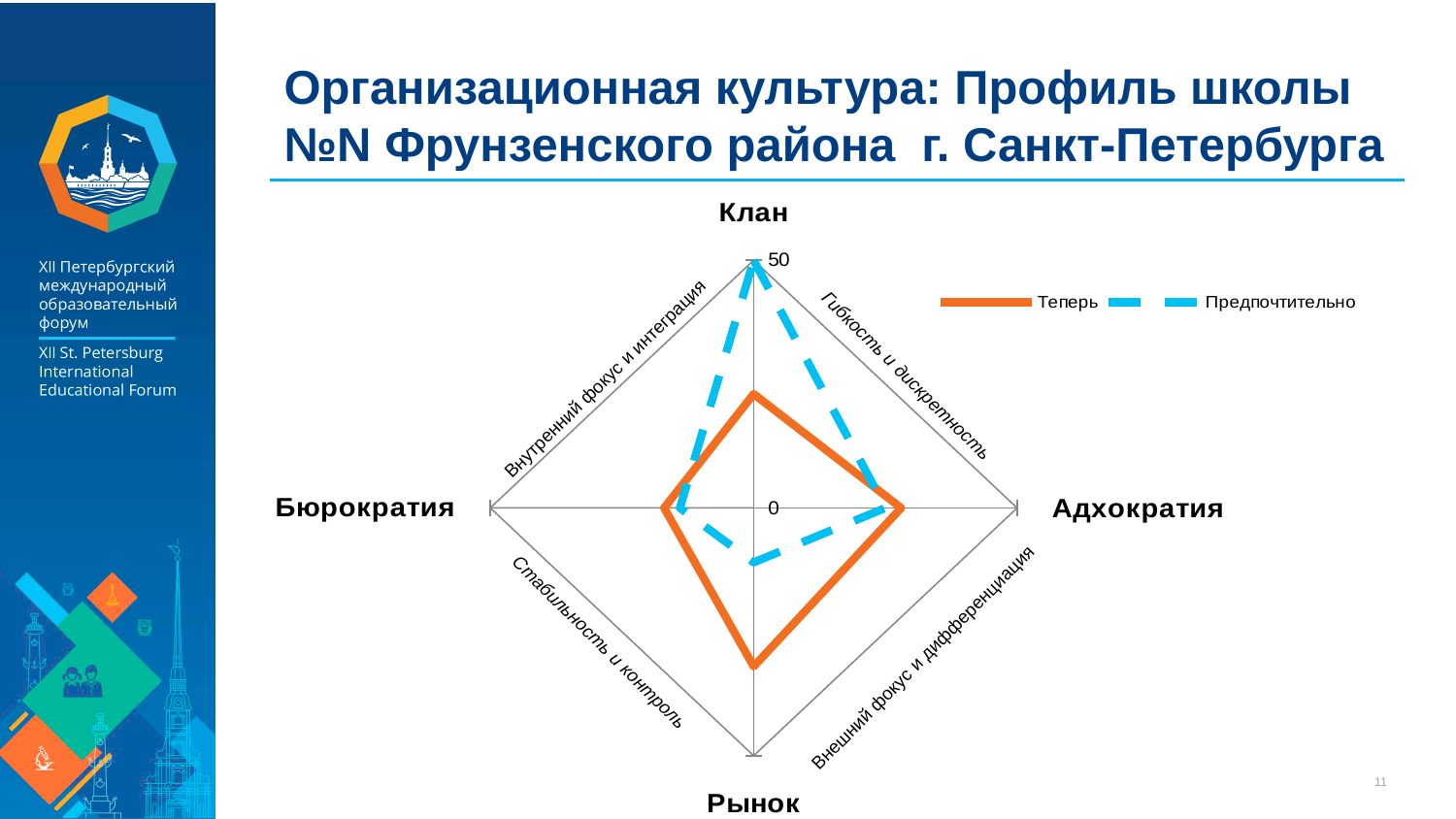
How many categories (axes) does the radar chart have? 4 Is the Предпочтительно value for Рынок greater or less than 50? less Which category is at the top of the radar chart? Клан What kind of chart is shown on the slide? Radar chart In which category does the Предпочтительно series have its highest value? Клан For Рынок, which series has the larger value, Теперь or Предпочтительно? Теперь Is the Теперь value for Рынок greater or less than 50? less How many series does the chart legend list? 2 What are the two series named in the legend? Теперь and Предпочтительно Is the Теперь value for Клан greater or less than 50? less For Клан, which series has the larger value, Теперь or Предпочтительно? Предпочтительно What is the Предпочтительно value for Клан? 50